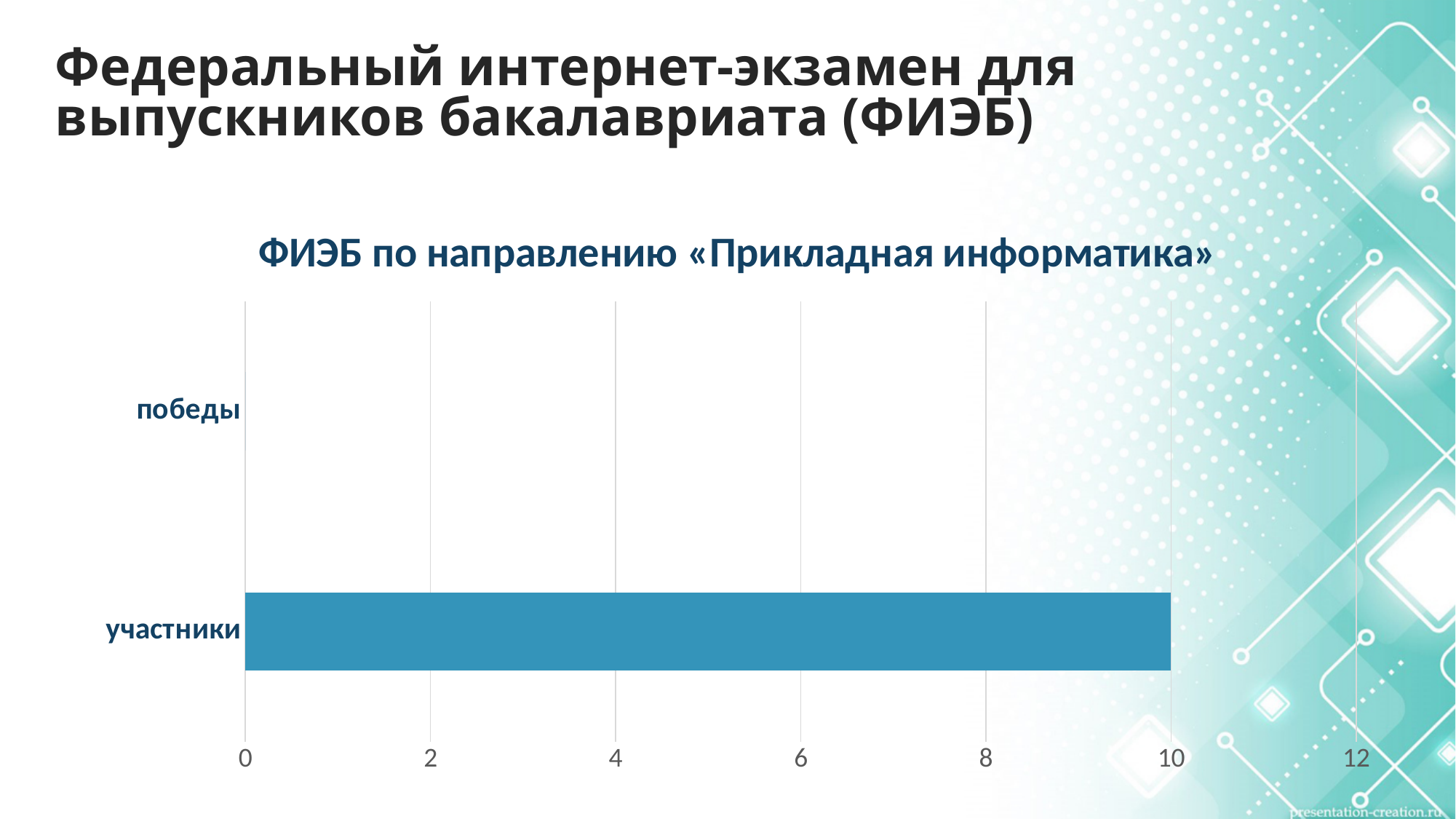
Which category has the highest value? участники Is the value for участники greater or less than 12? less Is the value for победы greater or less than 2? less Is the value for участники greater or less than 8? greater What kind of chart is shown on the slide? bar chart What is the title of the chart? ФИЭБ по направлению «Прикладная информатика» Which is larger, the value for участники or the value for победы? участники What is the value for участники? 10 Which category has the lowest value? победы How many categories are shown on the chart? 2 What is the highest tick value shown on the horizontal axis? 12